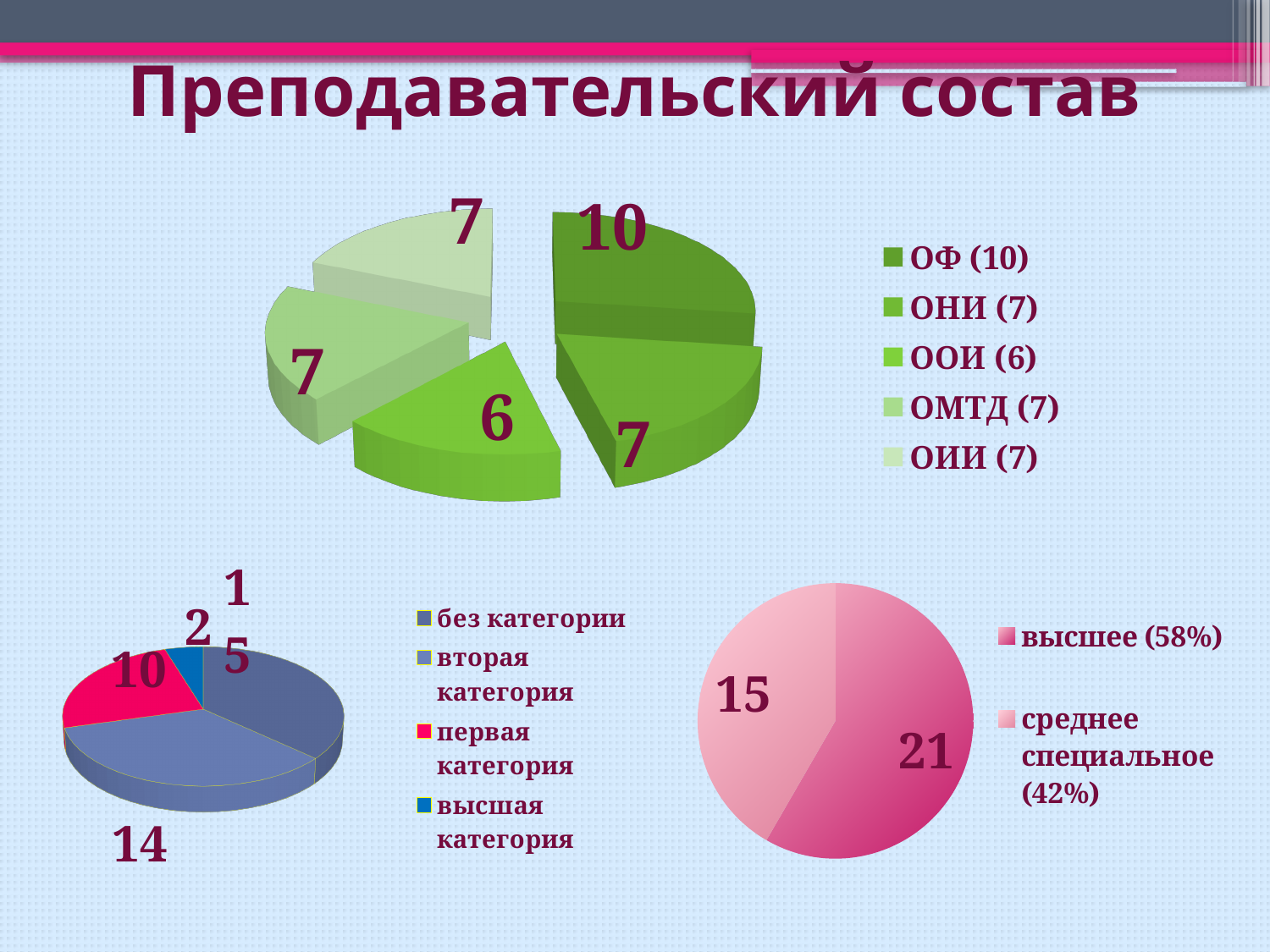
On the bottom-left pie chart, what is the value for первая категория? 10 On the top pie chart, what is the value for ОФ? 10 What kind of chart is the bottom-right chart? pie chart On the bottom-right pie chart, what is the value for среднее специальное? 15 On the bottom-left pie chart, which is larger: вторая категория or первая категория? вторая категория On the bottom-right pie chart, what share of the pie does высшее represent? 58% On the top pie chart, which category has the lowest value? ООИ On the bottom-left pie chart, which category has the lowest value? высшая категория On the top pie chart, how many categories are shown? 5 On the top pie chart, what is the difference between the values for ОФ and ООИ? 4 On the top pie chart, which category has the highest value? ОФ On the top pie chart, what is the value for ООИ? 6